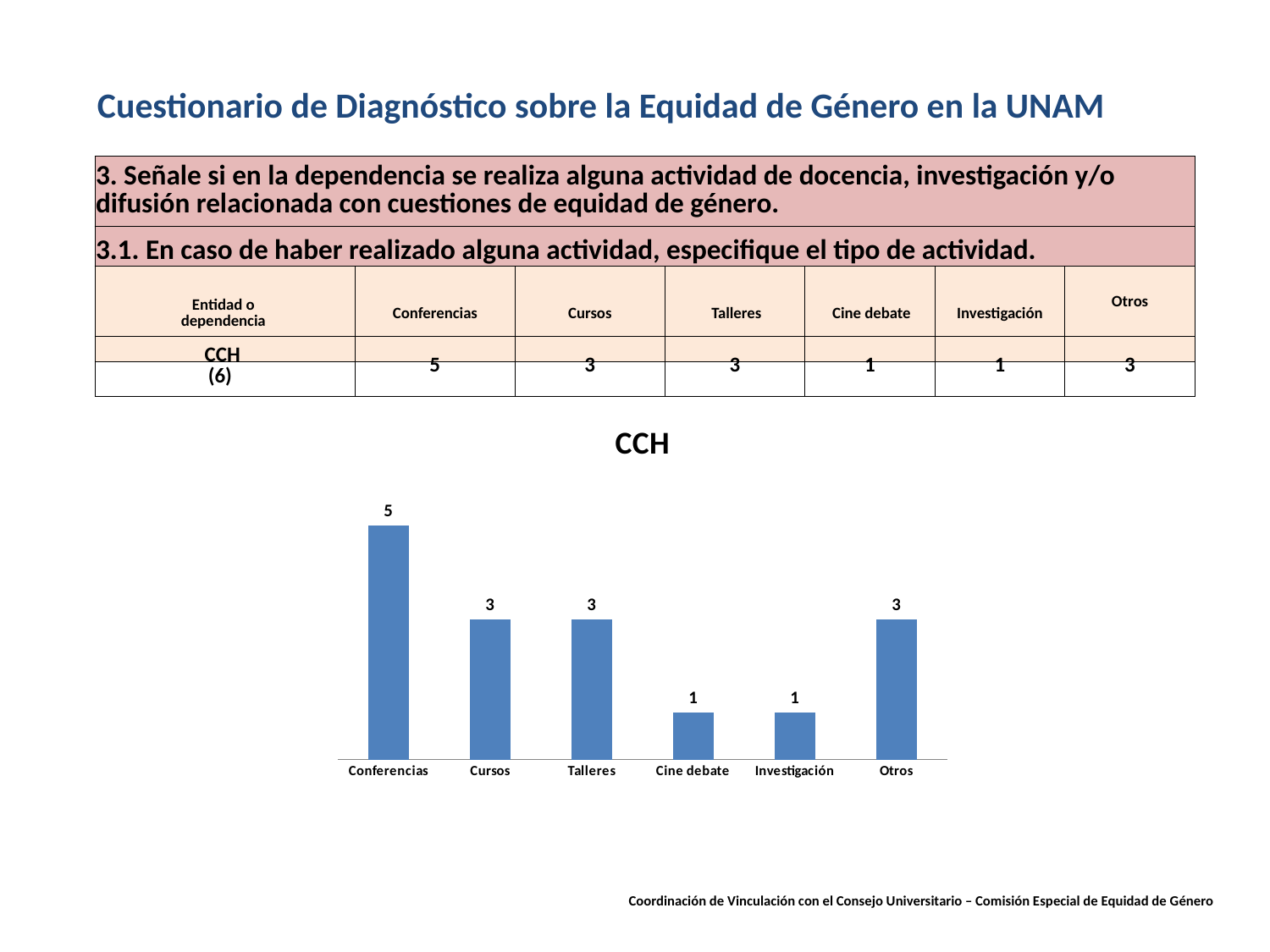
What is the value for Cine debate in the CCH chart? 1 What is the value for Conferencias in the CCH chart? 5 What is the title of the chart on the slide? CCH Which is larger in the CCH chart, Talleres or Investigación? Talleres What is the value for Otros in the CCH chart? 3 What is the difference between the values for Conferencias and Cursos in the CCH chart? 2 What is the difference between the values for Otros and Cine debate in the CCH chart? 2 Which category has the highest value in the CCH chart? Conferencias What kind of chart is shown on the slide? Bar chart Which two categories share the lowest value in the CCH chart? Cine debate and Investigación How many categories are shown on the x axis of the CCH chart? 6 What is the value for Cursos in the CCH chart? 3